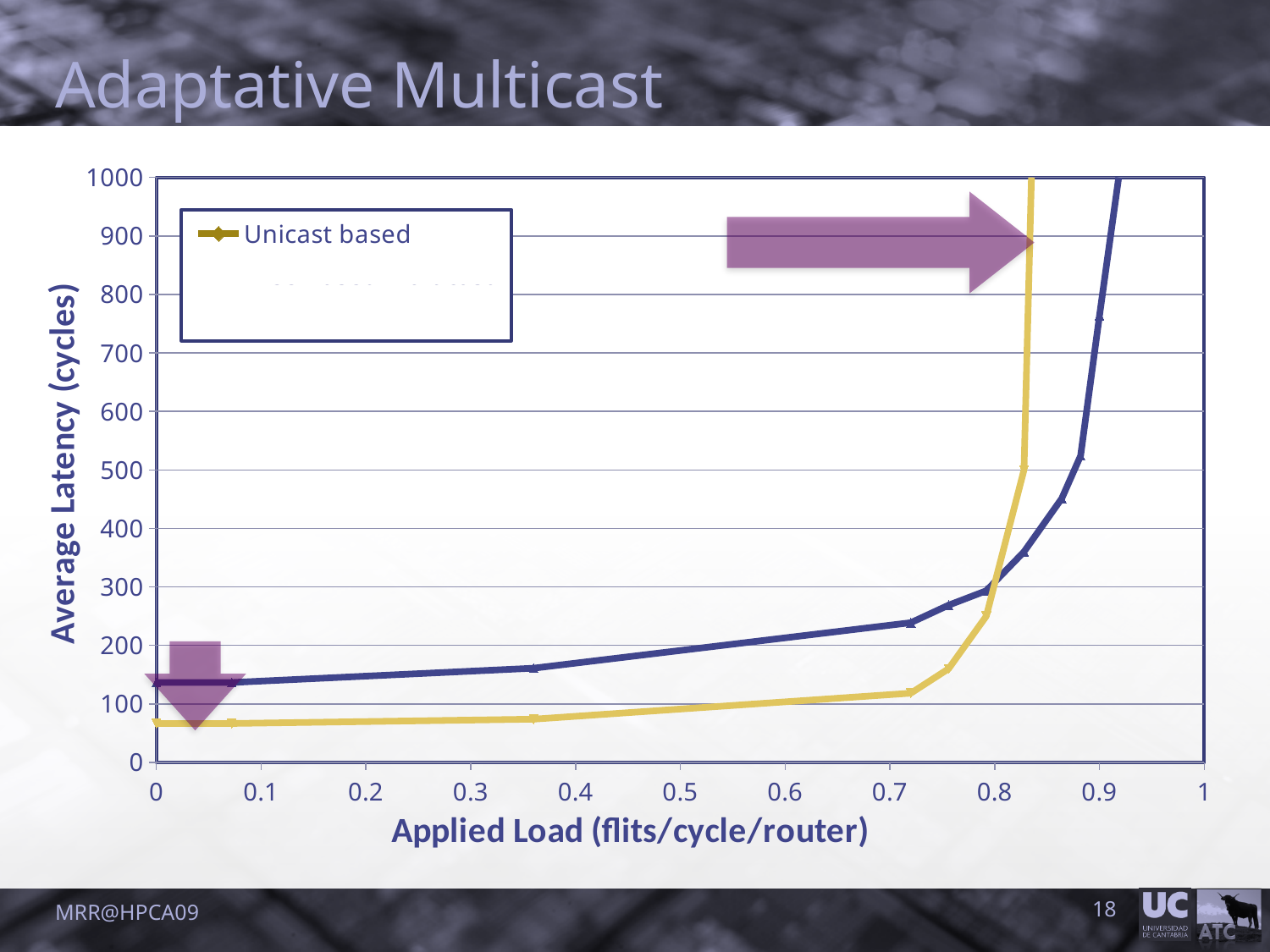
Is the Unicast based value at an applied load of 0 greater or less than 100? less Is the Unicast based value at an applied load of 0.5 greater or less than 200? less Is the Unicast based value at an applied load of 0.7 greater or less than 100? greater What is the label of the y axis? Average Latency (cycles) Does the Unicast based series rise or fall as applied load increases? rise What is the label of the x axis? Applied Load (flits/cycle/router) What kind of chart is shown on the slide? line chart What is the highest value shown on the y axis? 1000